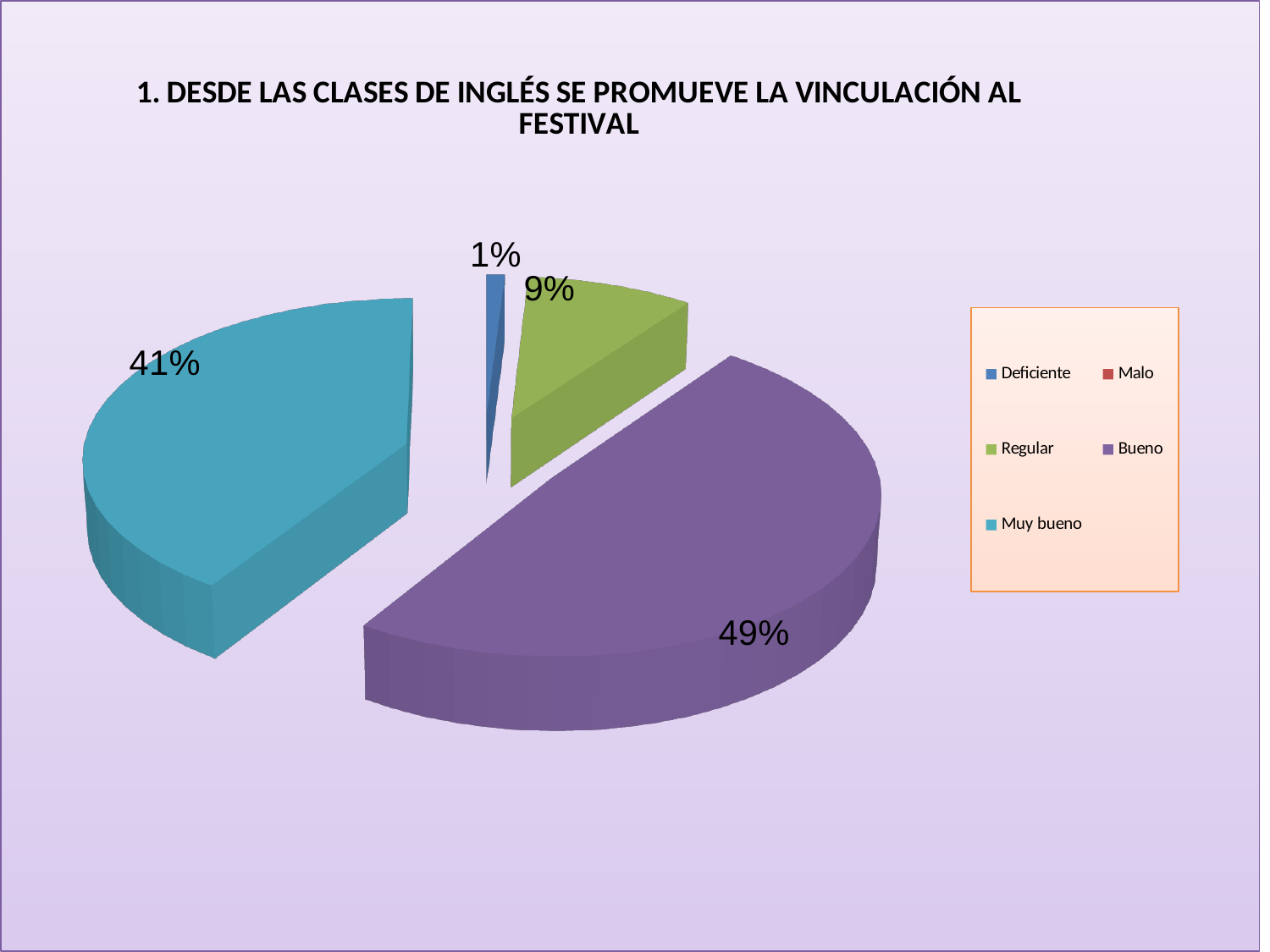
What percentage of the pie does Deficiente represent? 1% What percentage of the pie does Muy bueno represent? 41% What percentage of the pie does Bueno represent? 49% How many entries does the legend list? 5 What is the difference in percentage points between Regular and Deficiente? 8% Which is larger, the slice for Regular or the slice for Deficiente? Regular Which category has the largest slice of the pie? Bueno What is the difference in percentage points between Bueno and Muy bueno? 8% What is the combined share of Bueno and Muy bueno? 90% What kind of chart is shown on the slide? Pie chart What percentage of the pie does Regular represent? 9% What colour is the slice for Muy bueno? Teal (blue-green)